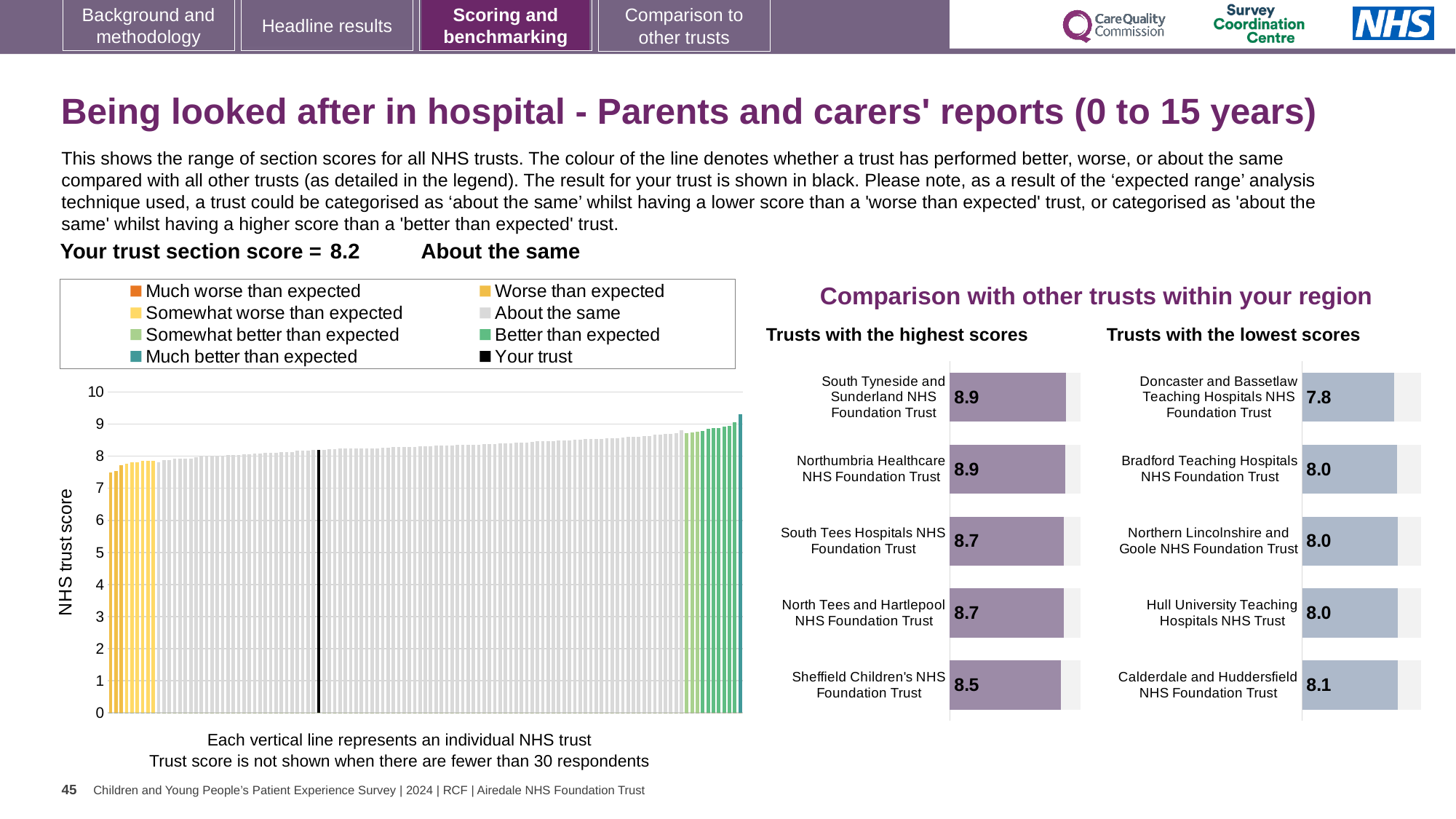
In the 'Trusts with the lowest scores' chart, which trust has the highest score? Calderdale and Huddersfield NHS Foundation Trust In the main NHS trust score chart, do the values rise or fall from left to right along the x axis? Rise In the 'Trusts with the highest scores' chart, what is the score for Sheffield Children's NHS Foundation Trust? 8.5 What kind of chart is the main chart on the left showing NHS trust scores? Bar chart In the 'Trusts with the highest scores' chart, which trust has the lowest score? Sheffield Children's NHS Foundation Trust How many trusts are shown in the 'Trusts with the lowest scores' chart? 5 In the 'Trusts with the highest scores' chart, what is the difference between the scores of South Tyneside and Sunderland NHS Foundation Trust and Sheffield Children's NHS Foundation Trust? 0.4 In the main NHS trust score chart, is the value of the leftmost (lowest) bar greater or less than 8? less In the 'Trusts with the lowest scores' chart, what is the score for Doncaster and Bassetlaw Teaching Hospitals NHS Foundation Trust? 7.8 In the 'Trusts with the lowest scores' chart, which has the larger score: Bradford Teaching Hospitals NHS Foundation Trust or Calderdale and Huddersfield NHS Foundation Trust? Calderdale and Huddersfield NHS Foundation Trust How many entries does the legend of the main NHS trust score chart list? 8 In the 'Trusts with the highest scores' chart, what is the score for South Tees Hospitals NHS Foundation Trust? 8.7